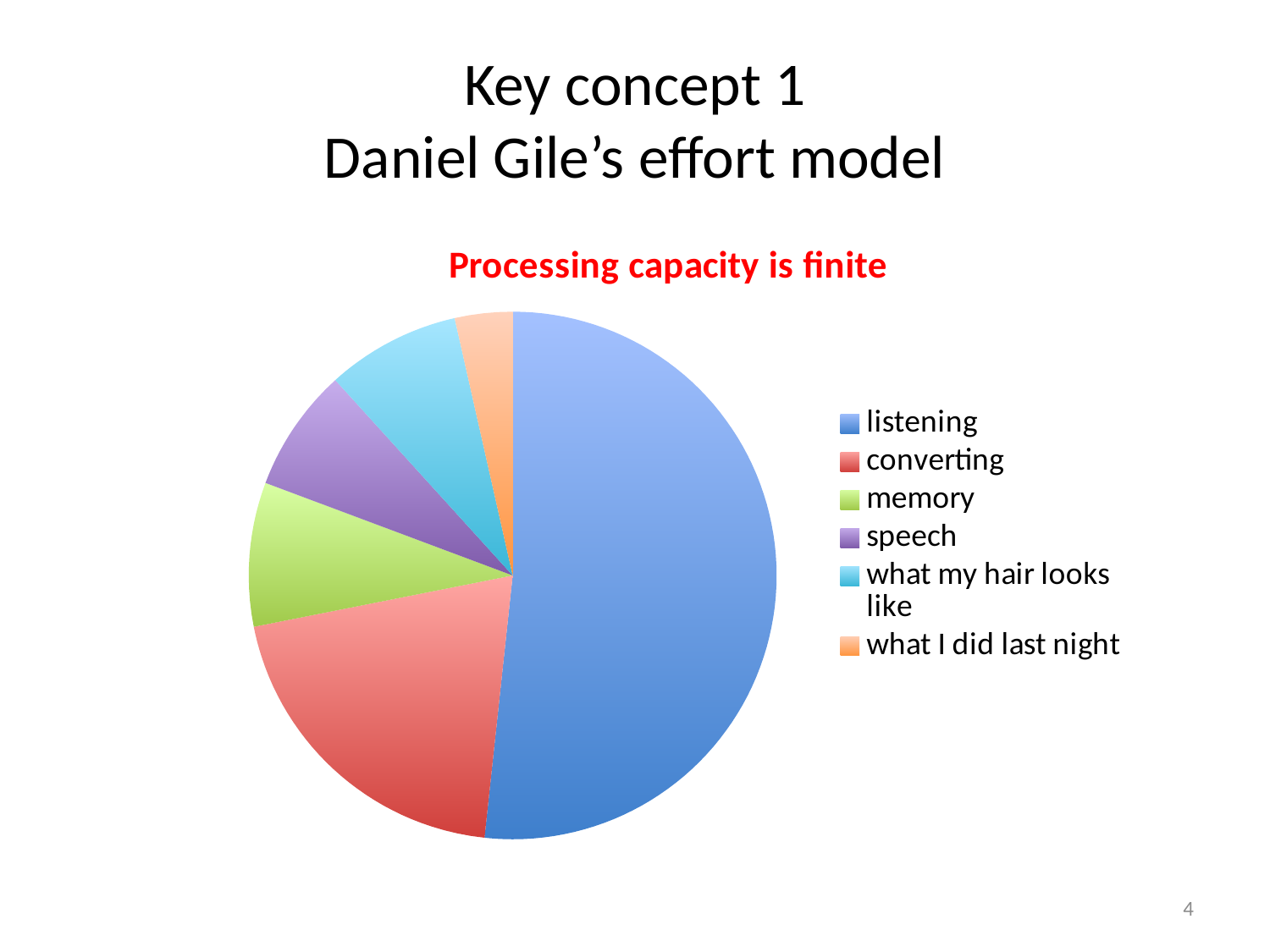
What colour is the listening slice in the pie chart? blue What kind of chart is shown on the slide? pie chart Which slice is larger, converting or speech? converting Which slice is larger, converting or memory? converting Which category has the smallest slice of the pie? what I did last night How many entries does the chart's legend list? 6 How many categories (slices) does the pie chart have? 6 Which slice is larger, what my hair looks like or what I did last night? what my hair looks like What is the title of the chart? Processing capacity is finite Which category has the largest slice of the pie? listening